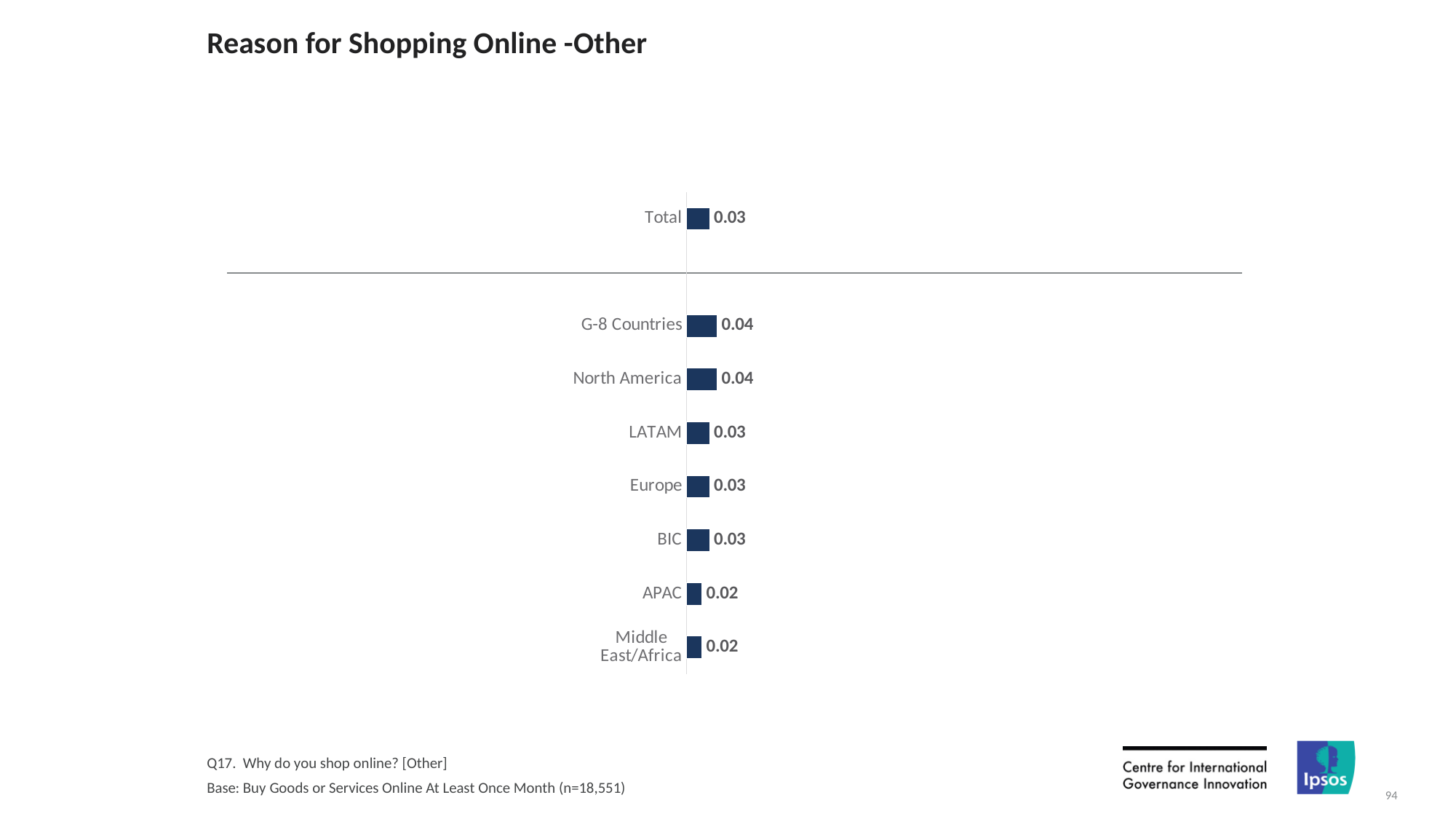
What is the value for Middle East/Africa? 0.02 What is the value for APAC? 0.02 What is the value for G-8 Countries? 0.04 What is the value for North America? 0.04 What is the value for Total? 0.03 What is the difference between the value for LATAM and the value for Middle East/Africa? 0.01 Which is larger, the value for G-8 Countries or the value for APAC? G-8 Countries What kind of chart is shown on the slide? Bar chart What is the difference between the value for North America and the value for APAC? 0.02 What is the value for Europe? 0.03 How many bars are plotted in the chart? 8 Which is larger, the value for Middle East/Africa or the value for North America? North America